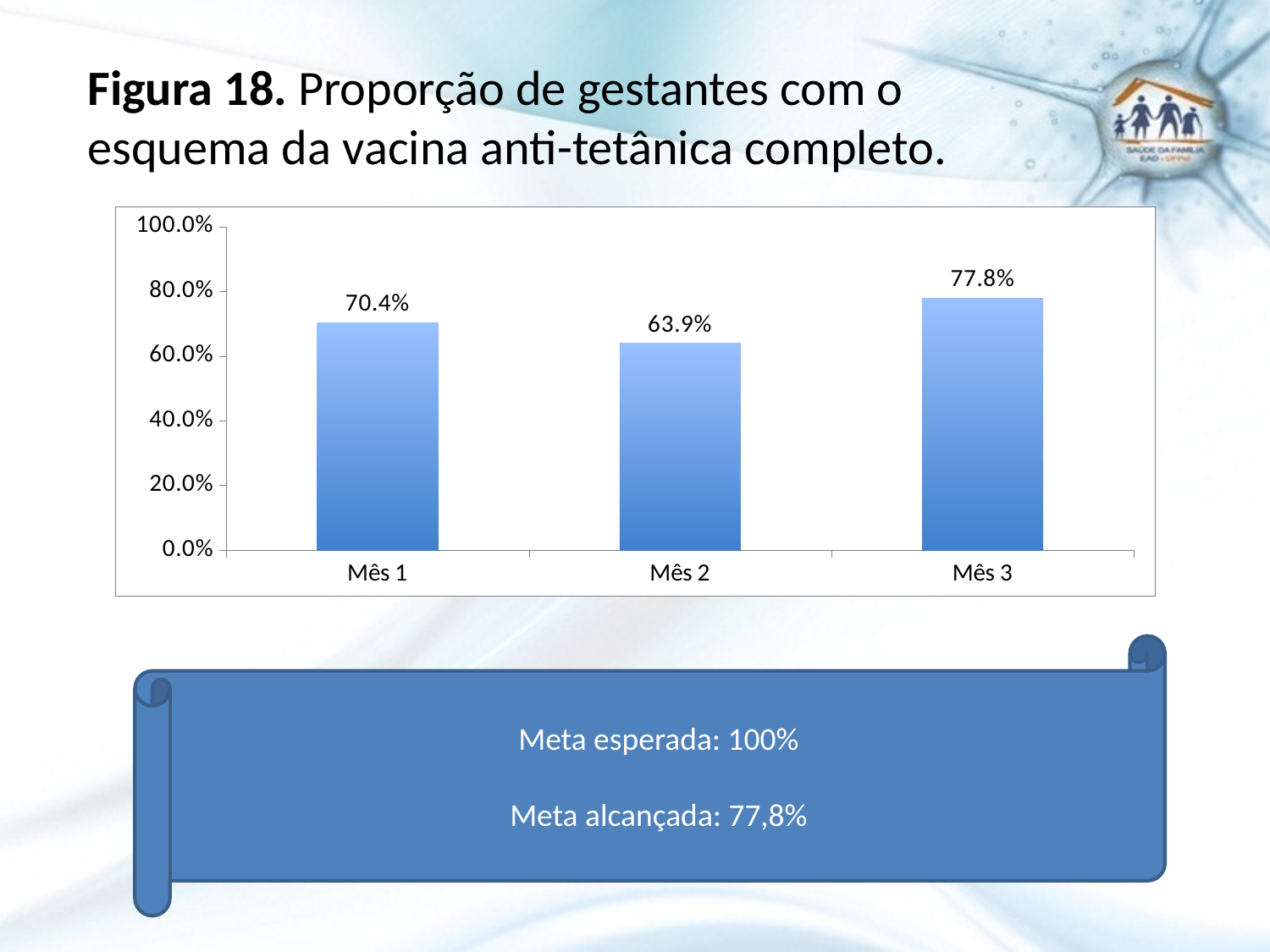
Which month has the highest value? Mês 3 What is the maximum value shown on the y axis? 100.0% Which month has the lowest value? Mês 2 How many months are shown on the x axis? 3 What is the value for Mês 2? 63.9% Which is larger, the value for Mês 1 or the value for Mês 3? Mês 3 What is the difference between the values for Mês 1 and Mês 2? 6.5% What is the difference between the values for Mês 3 and Mês 2? 13.9% Is the value for Mês 2 greater or less than 80.0%? less What kind of chart is shown on the slide? bar chart What is the value for Mês 3? 77.8% What is the value for Mês 1? 70.4%